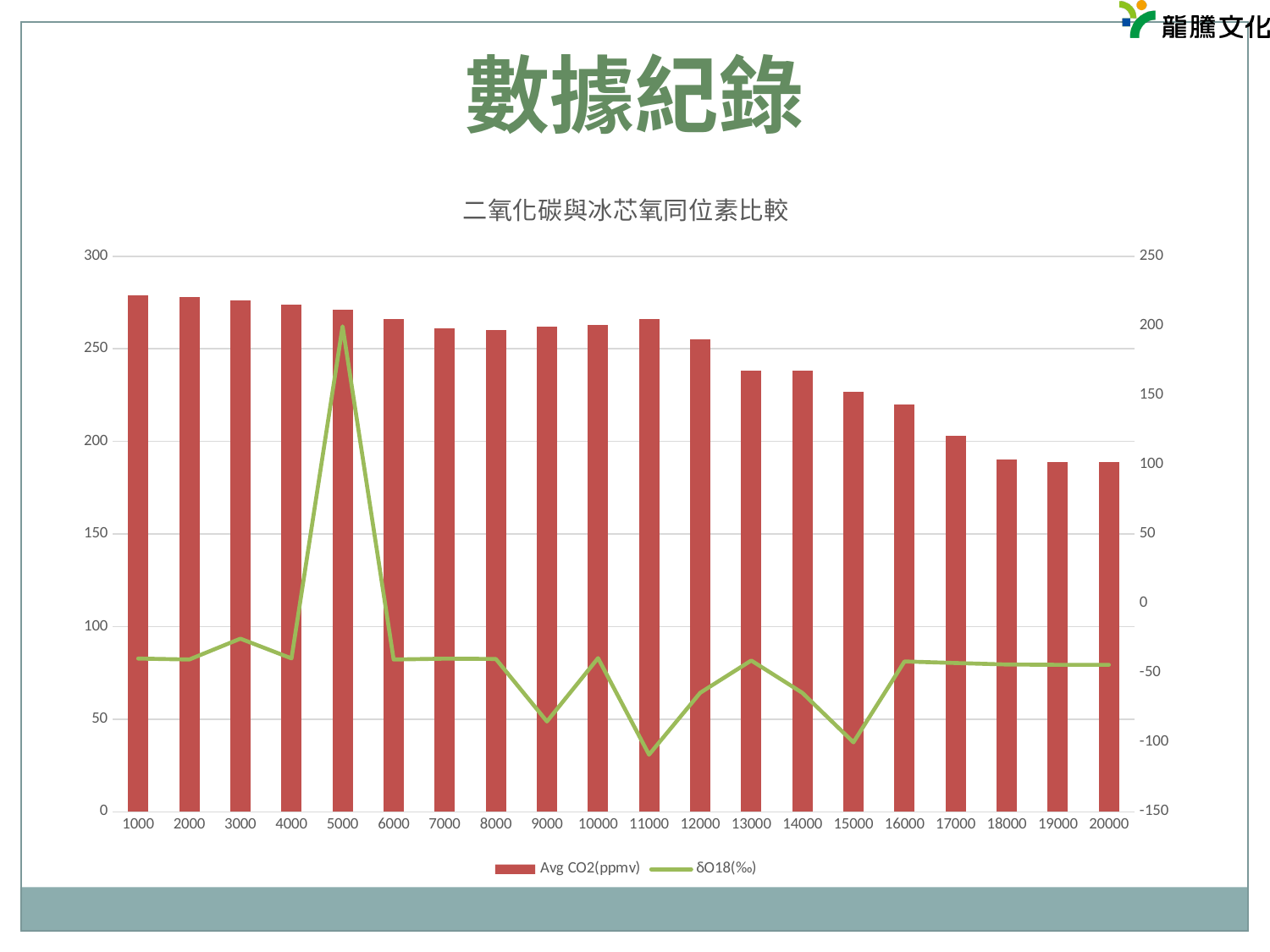
Which has the larger Avg CO2(ppmv) value, 1000 or 20000? 1000 Is the Avg CO2(ppmv) value at 16000 greater or less than 200? greater How many series does the legend list? 2 Do the Avg CO2(ppmv) bars generally rise or fall from 1000 to 20000? fall Is the Avg CO2(ppmv) value at 13000 greater or less than 250? less Is the Avg CO2(ppmv) value at 1000 greater or less than 250? greater How many categories are shown on the x axis? 20 At which x-axis category does the δO18(‰) line reach its highest value? 5000 What kind of chart is shown on the slide? A combination bar and line chart Which series is drawn as a line? δO18(‰) What is the title of the chart? 二氧化碳與冰芯氧同位素比較